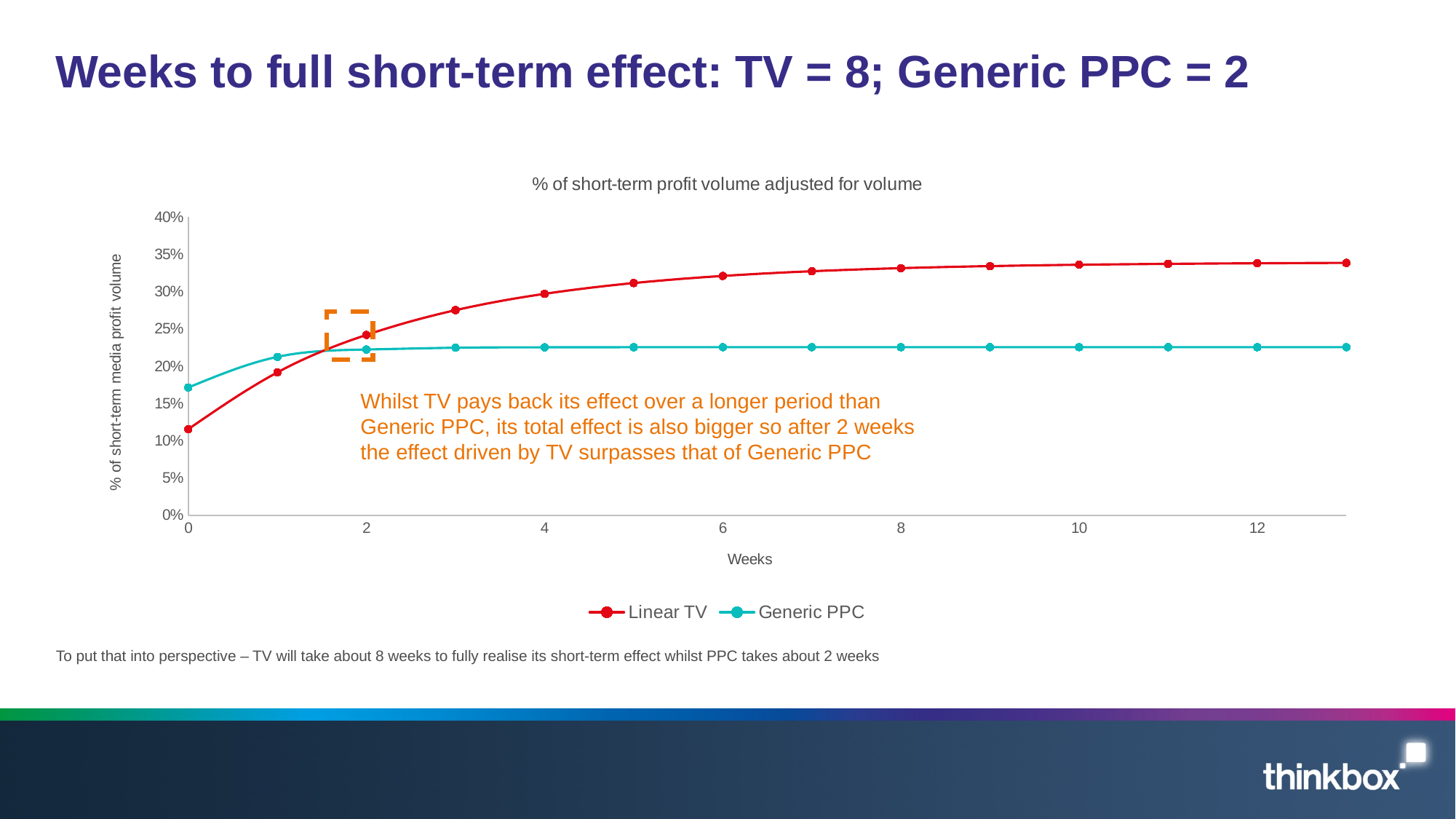
Is the value for Linear TV at week 8 greater or less than 30%? greater What is the title of the chart? % of short-term profit volume adjusted for volume At week 0, which series has the higher value, Linear TV or Generic PPC? Generic PPC Does the Linear TV line rise or fall as the weeks increase? Rise Is the value for Linear TV at week 0 greater or less than 15%? less Is the value for Generic PPC at week 12 greater or less than 25%? less How many data points are plotted for the Linear TV series? 14 How many series does the legend list? 2 Which two series are listed in the legend? Linear TV and Generic PPC What kind of chart is shown on the slide? Line chart At week 8, which series has the higher value, Linear TV or Generic PPC? Linear TV